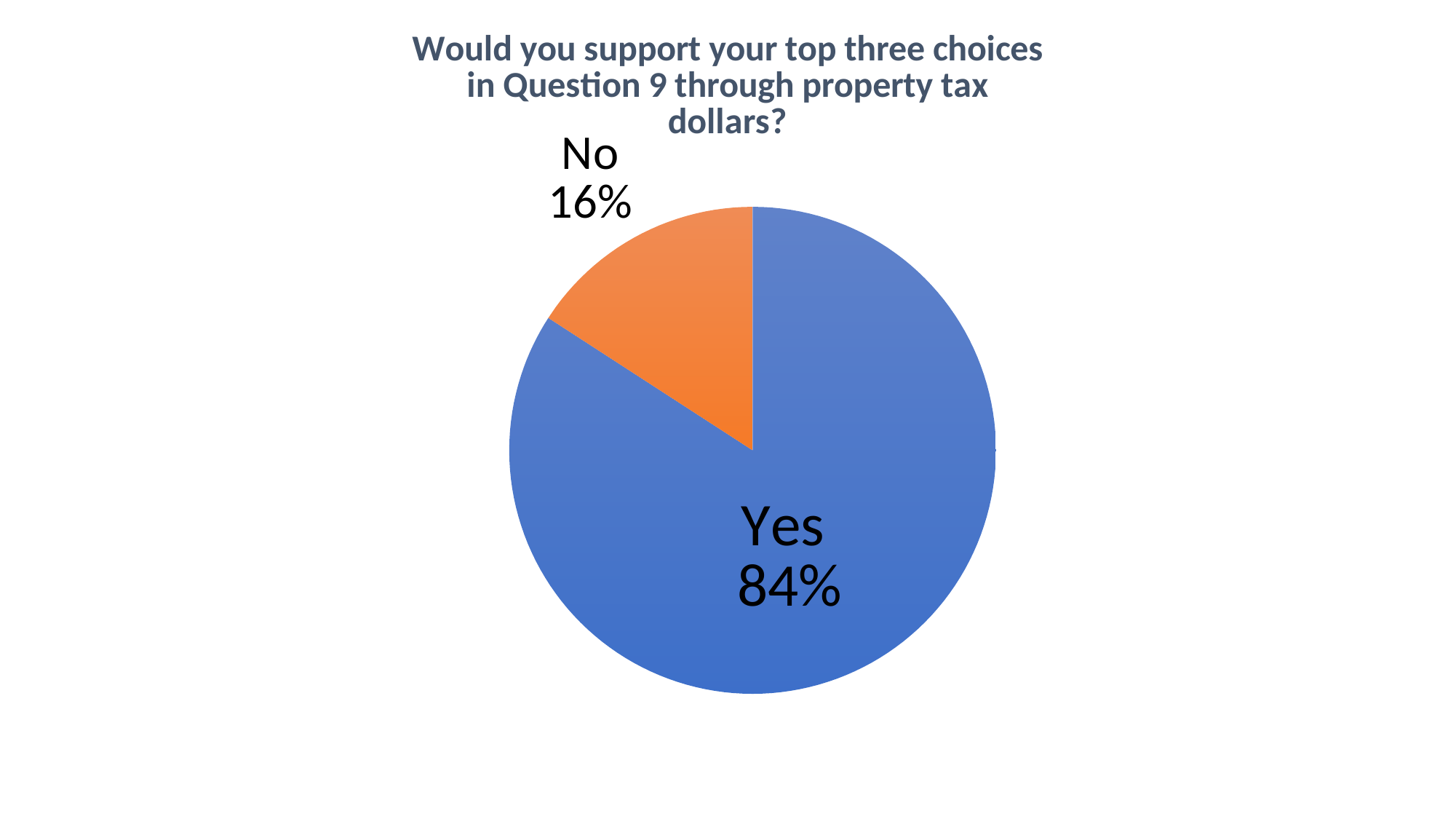
Which is larger, the Yes slice or the No slice? Yes What share of the pie is labelled No? 16% What is the difference in percentage points between the Yes and No slices? 68 What is the value shown for the Yes slice? 84% What kind of chart is shown on the slide? pie chart Which slice is the smallest? No What is the title of the chart? Would you support your top three choices in Question 9 through property tax dollars? How many slices does the pie chart have? 2 What colour is the No slice? orange Which slice is the largest? Yes What share of the pie is labelled Yes? 84% What is the value shown for the No slice? 16%